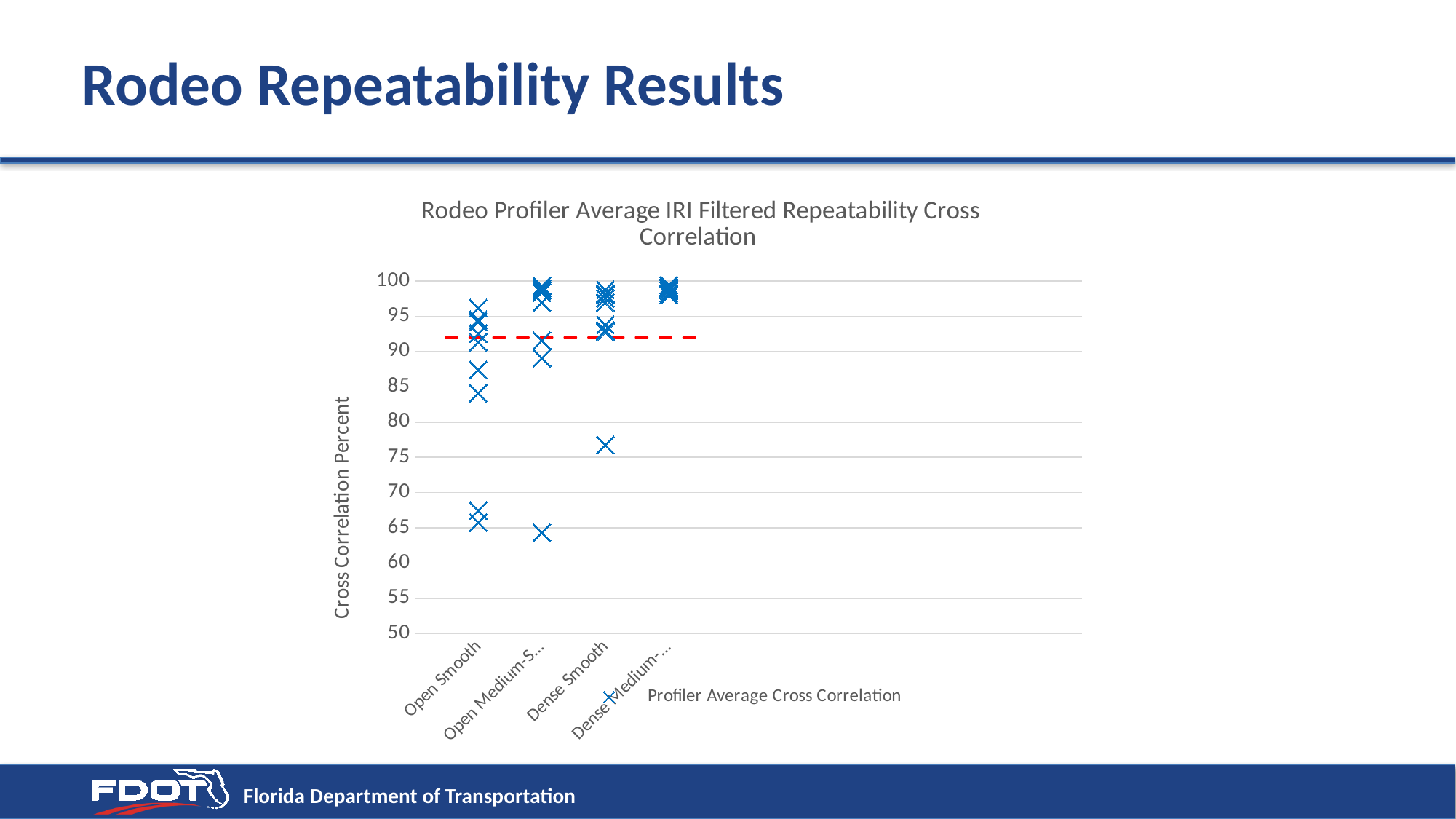
What kind of chart is shown on the slide? scatter chart Is the lowest plotted point for Open Smooth greater or less than 70? less Is the highest plotted point for Open Smooth greater or less than 95? greater Are all the plotted points for the fourth category (Dense Medium-...) greater or less than 95? greater How many categories are shown along the x axis of the chart? 4 How many series does the chart legend list? 1 What is the highest value shown on the y axis of the chart? 100 What is the lowest value shown on the y axis of the chart? 50 What is the name of the series listed in the chart legend? Profiler Average Cross Correlation What is the title of the chart? Rodeo Profiler Average IRI Filtered Repeatability Cross Correlation